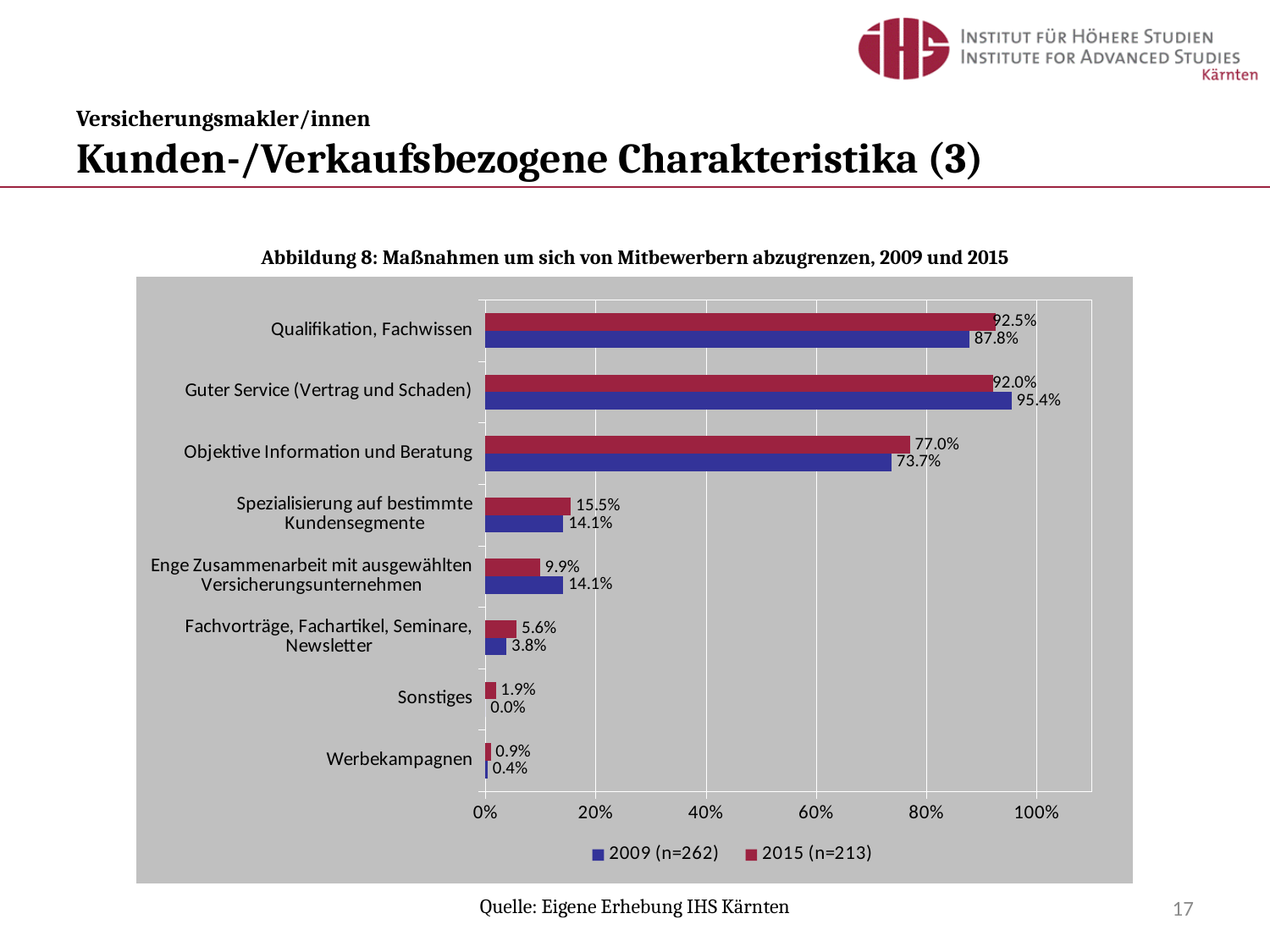
What is the sample size (n) given in the legend for 2015? 213 For "Fachvorträge, Fachartikel, Seminare, Newsletter", which year has the larger value, 2009 or 2015? 2015 What is the 2009 value for "Enge Zusammenarbeit mit ausgewählten Versicherungsunternehmen"? 14.1% How many series does the legend list? 2 Which category has the highest 2009 value? Guter Service (Vertrag und Schaden) What kind of chart is shown on the slide? bar chart What is the title of the chart? Abbildung 8: Maßnahmen um sich von Mitbewerbern abzugrenzen, 2009 und 2015 What is the difference between the 2015 and 2009 values for "Objektive Information und Beratung"? 3.3% Which category has the lowest 2015 value? Werbekampagnen How many categories are shown in the chart? 8 What is the 2009 value for "Guter Service (Vertrag und Schaden)"? 95.4% What is the 2015 value for "Qualifikation, Fachwissen"? 92.5%